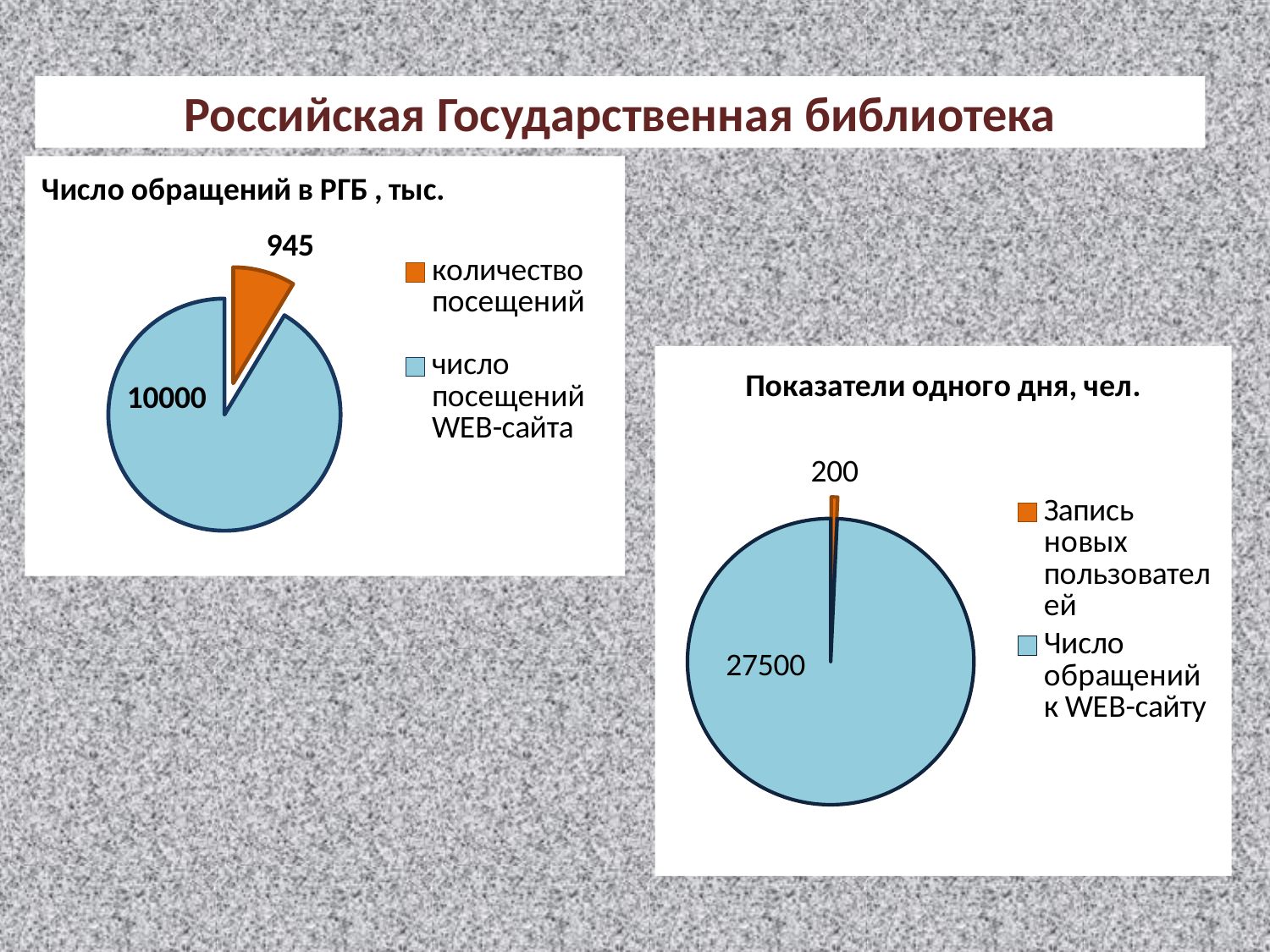
In the chart titled "Число обращений в РГБ , тыс.", what colour is the slice for "количество посещений"? orange In the chart titled "Показатели одного дня, чел.", what is the value for "Запись новых пользователей"? 200 In the chart titled "Число обращений в РГБ , тыс.", which category has the largest slice? число посещений WEB-сайта In the chart titled "Число обращений в РГБ , тыс.", what is the difference between the two slice values? 9055 In the chart titled "Показатели одного дня, чел.", what is the difference between the two slice values? 27300 In the chart titled "Число обращений в РГБ , тыс.", what is the value for "количество посещений"? 945 In the chart titled "Число обращений в РГБ , тыс.", what is the value for "число посещений WEB-сайта"? 10000 In the chart titled "Показатели одного дня, чел.", which category has the smallest slice? Запись новых пользователей In the chart titled "Показатели одного дня, чел.", which is larger: "Запись новых пользователей" or "Число обращений к WEB-сайту"? Число обращений к WEB-сайту What kind of chart is the chart titled "Число обращений в РГБ , тыс."? pie chart How many slices does the chart titled "Показатели одного дня, чел." have? 2 In the chart titled "Показатели одного дня, чел.", what is the value for "Число обращений к WEB-сайту"? 27500